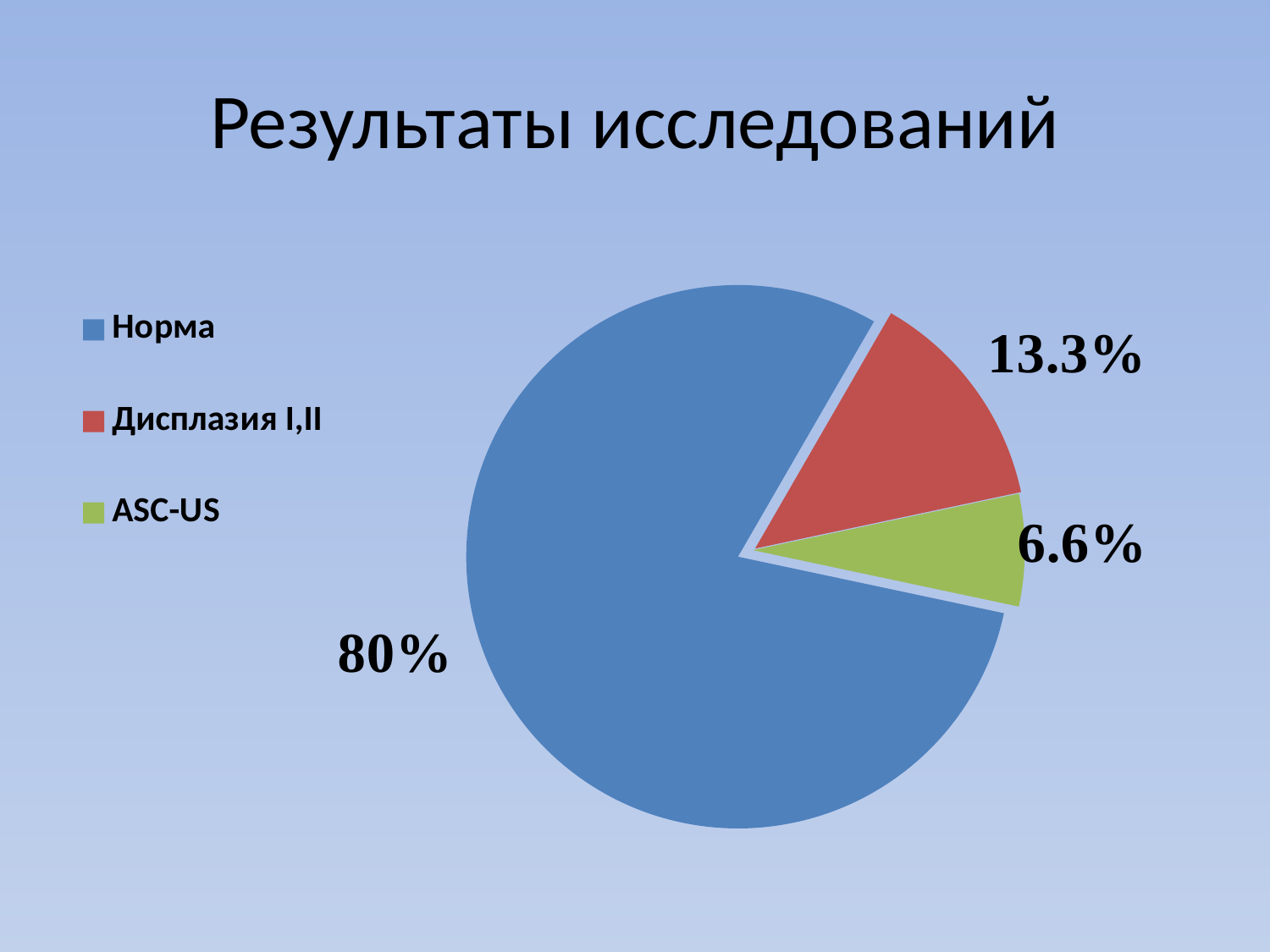
Which is larger, the share for Дисплазия I,II or the share for ASC-US? Дисплазия I,II What share of the pie does Дисплазия I,II represent? 13.3% What type of chart is shown on the slide? pie chart Which category has the smallest slice of the pie? ASC-US What colour is the slice for ASC-US? green What is the difference between the share for Норма and the share for Дисплазия I,II? 66.7% What is the title of the slide? Результаты исследований What share of the pie does Норма represent? 80% What share of the pie does ASC-US represent? 6.6% Which category has the largest slice of the pie? Норма What is the difference between the share for Дисплазия I,II and the share for ASC-US? 6.7% How many categories does the pie chart show? 3